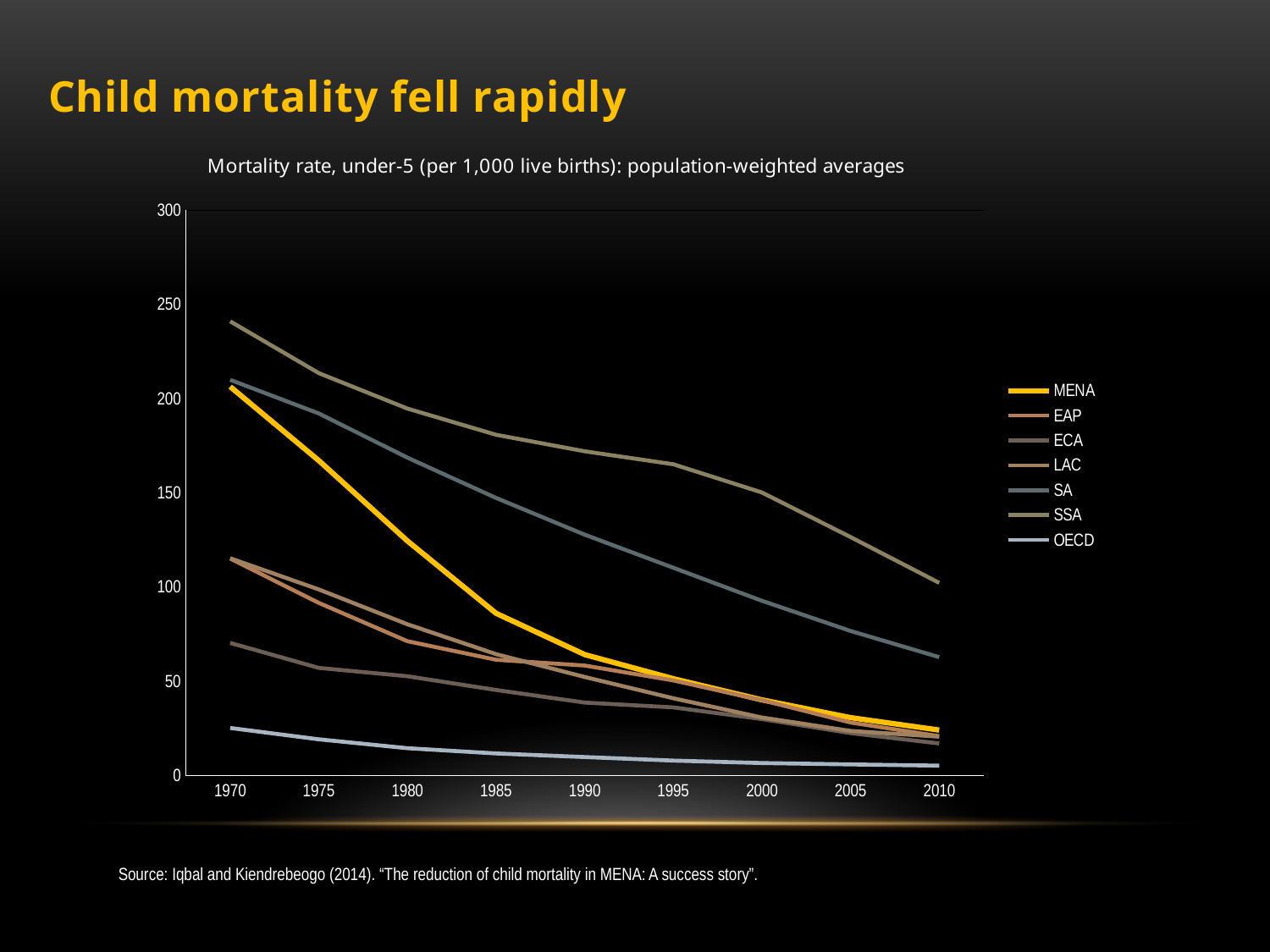
Does the MENA line rise or fall from 1970 to 2010? Fall In 1990, which is higher, MENA or OECD? MENA In 2000, which is higher, SSA or SA? SSA Is the value for SA in 2010 greater or less than 50? greater How many years are marked along the x axis? 9 How many series does the legend list? 7 Which region has the lowest under-5 mortality rate in 1970? OECD What kind of chart is shown on the slide? Line chart Is the value for OECD in 2010 greater or less than 50? less Is the value for SSA in 1970 greater or less than 200? greater Which region has the highest under-5 mortality rate in 1970? SSA What is the title of the chart? Mortality rate, under-5 (per 1,000 live births): population-weighted averages